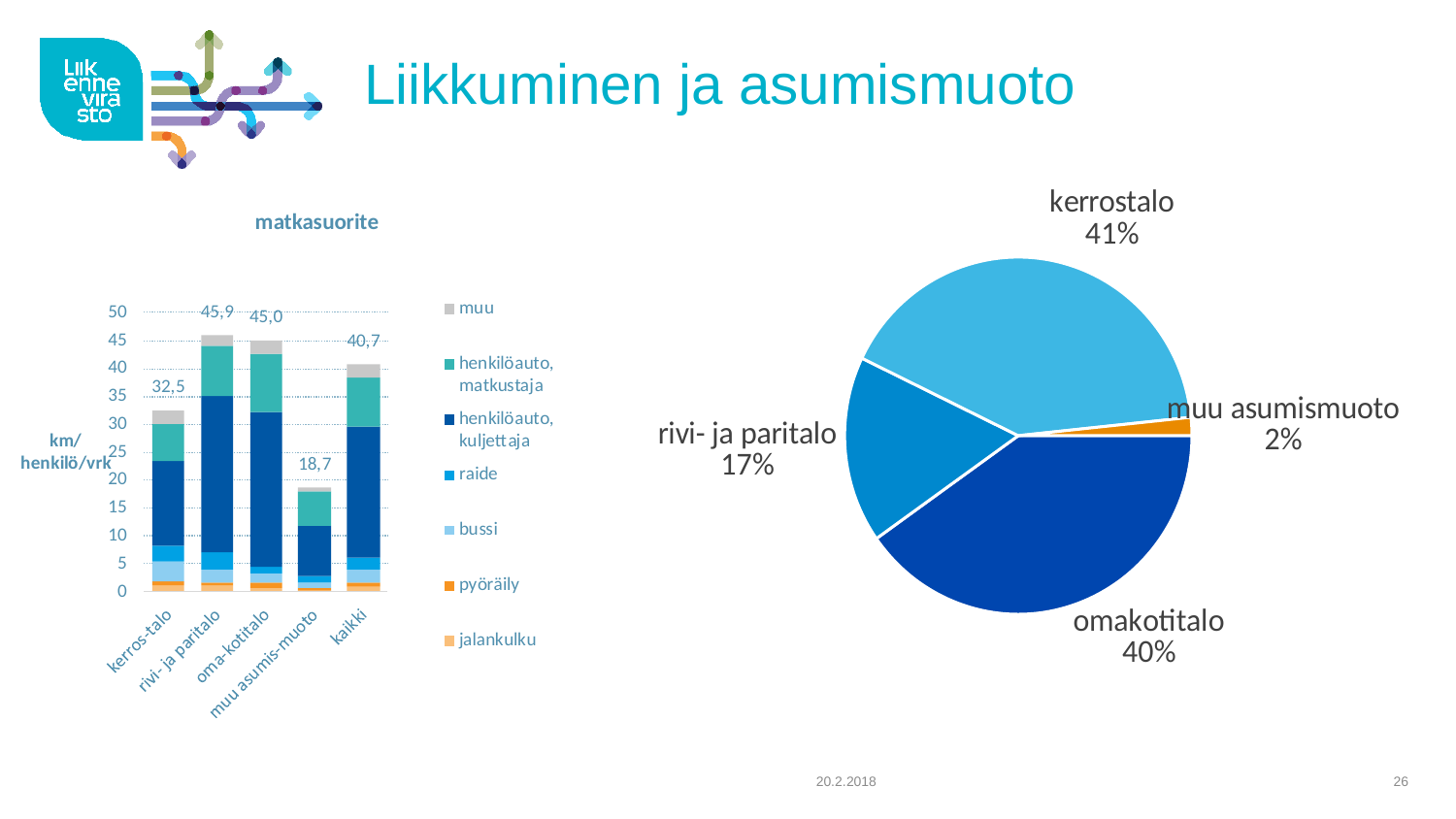
In the pie chart on the right, which slice is the smallest? muu asumismuoto What kind of chart is the 'matkasuorite' chart on the left? stacked bar chart In the 'matkasuorite' bar chart, what is the total value for kerros-talo? 32,5 In the 'matkasuorite' bar chart, how many categories are shown on the x axis? 5 In the 'matkasuorite' bar chart, what is the total value for kaikki? 40,7 In the 'matkasuorite' bar chart, how many series does the legend list? 7 In the pie chart on the right, what share does omakotitalo have? 40% In the 'matkasuorite' bar chart, which category has the lowest total? muu asumis-muoto In the 'matkasuorite' bar chart, what is the difference between the totals for rivi- ja paritalo and kerros-talo? 13,4 In the 'matkasuorite' bar chart, which category has the highest total? rivi- ja paritalo In the 'matkasuorite' bar chart, what is the total value for muu asumis-muoto? 18,7 In the pie chart on the right, how many slices are there? 4